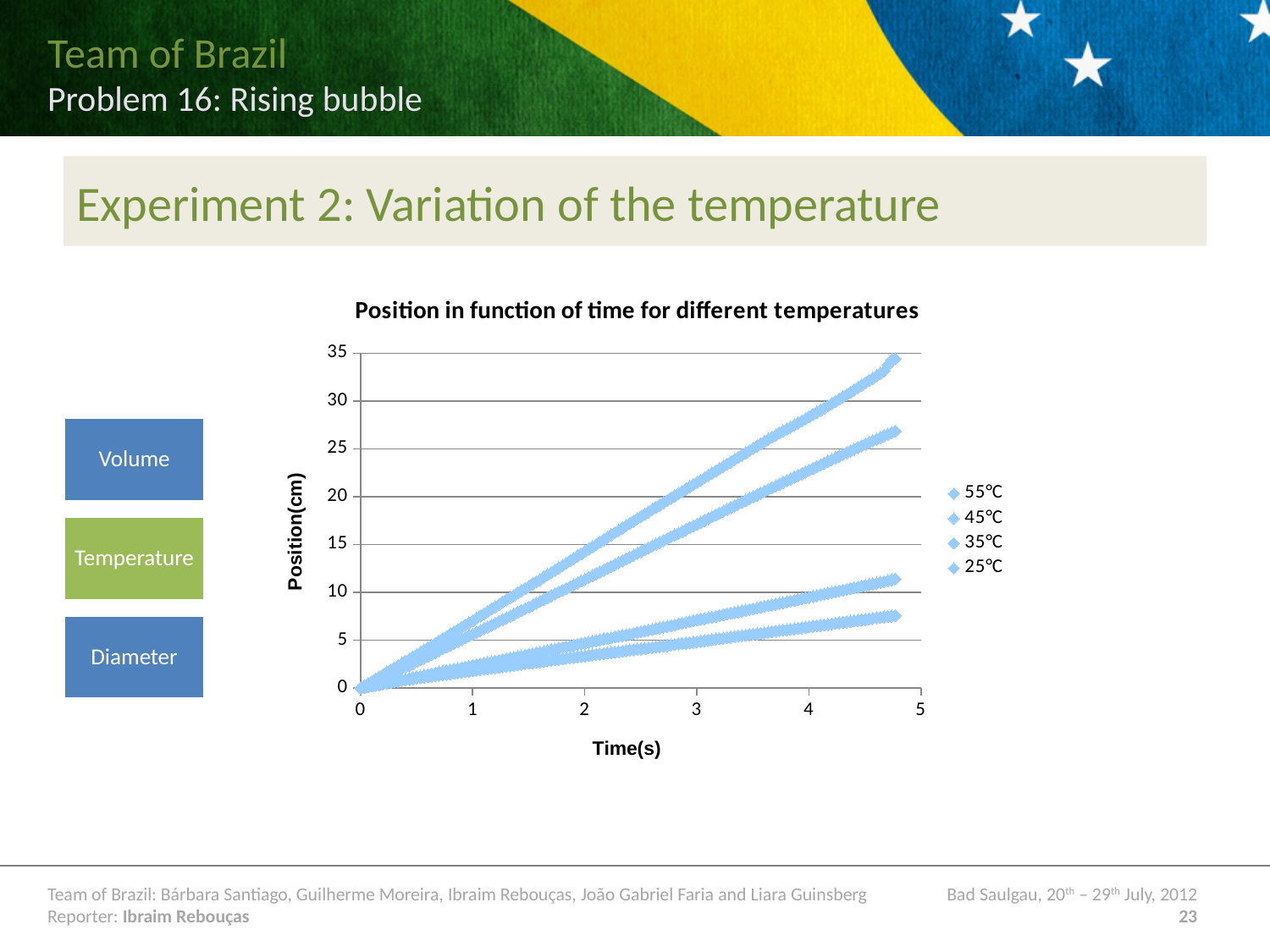
How many series does the chart legend list? 4 What is the highest value shown on the vertical axis of the chart? 35 Is the final position reached by the topmost series greater or less than 30? greater What is the highest value shown on the horizontal axis of the chart? 5 Do the plotted positions rise or fall as time increases along the x axis? rise What is the label of the vertical axis of the chart? Position(cm) Is the final position reached by the lowest series greater or less than 10? less What is the title of the chart? Position in function of time for different temperatures What kind of chart is shown on the slide? scatter chart Is the final position reached by the second-highest series greater or less than 25? greater